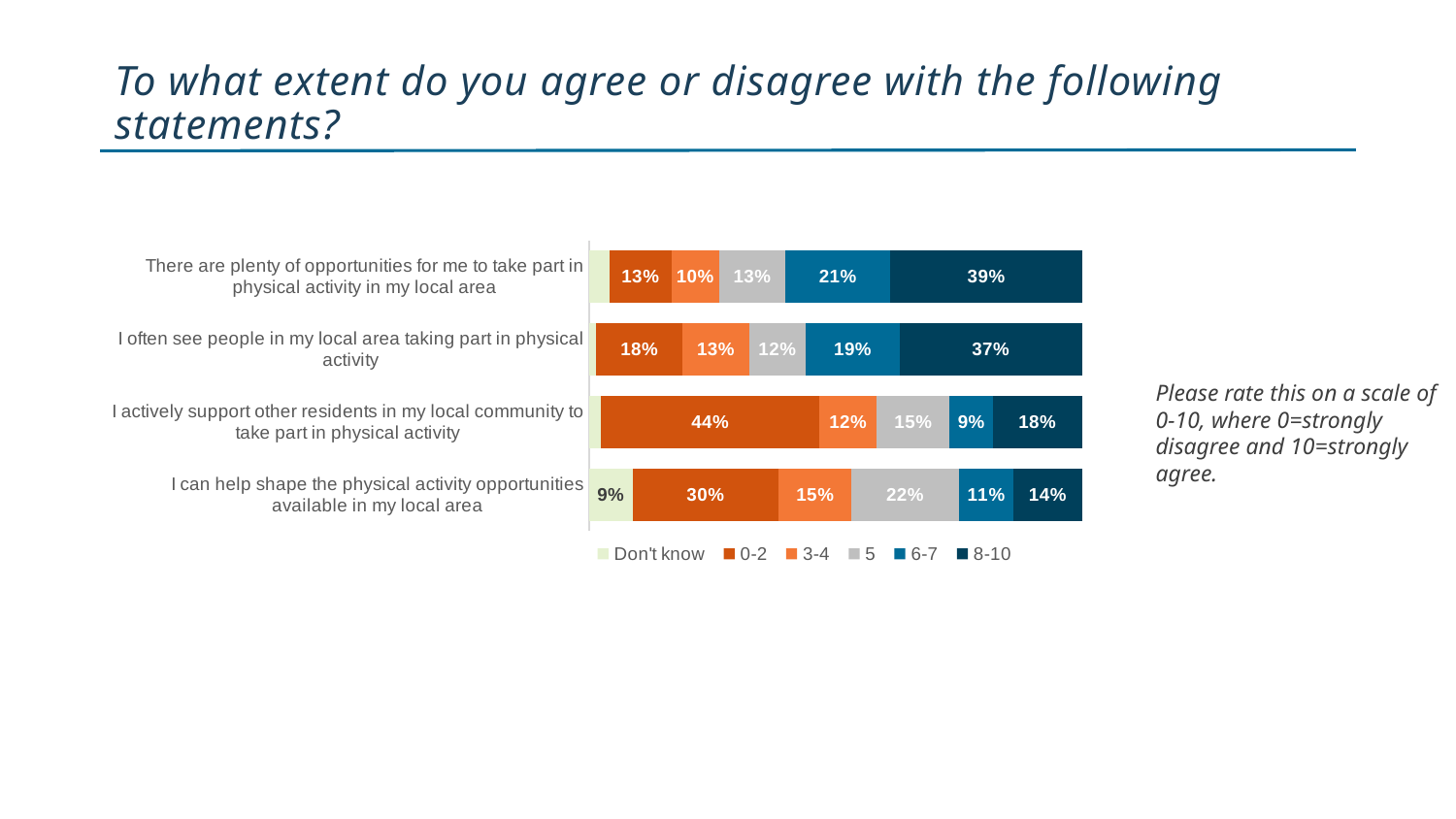
Which statement has the highest percentage of 8-10 ratings? There are plenty of opportunities for me to take part in physical activity in my local area How many statements are shown in the chart? 4 What percentage gave a rating of 0-2 for the statement "I actively support other residents in my local community to take part in physical activity"? 44% What is the difference in the 8-10 percentage between "There are plenty of opportunities for me to take part in physical activity in my local area" and "I often see people in my local area taking part in physical activity"? 2 percentage points How many series does the legend list? 6 What percentage gave a rating of 6-7 for the statement "I often see people in my local area taking part in physical activity"? 19% Which statement has a larger 0-2 percentage: "I actively support other residents in my local community to take part in physical activity" or "I can help shape the physical activity opportunities available in my local area"? I actively support other residents in my local community to take part in physical activity What is the "Don't know" percentage for the statement "I can help shape the physical activity opportunities available in my local area"? 9% What kind of chart is shown on the slide? Stacked bar chart What is the difference in the 0-2 percentage between "I actively support other residents in my local community to take part in physical activity" and "I can help shape the physical activity opportunities available in my local area"? 14 percentage points What percentage gave a rating of 8-10 for the statement "There are plenty of opportunities for me to take part in physical activity in my local area"? 39% Which statement has the lowest percentage of 8-10 ratings? I can help shape the physical activity opportunities available in my local area